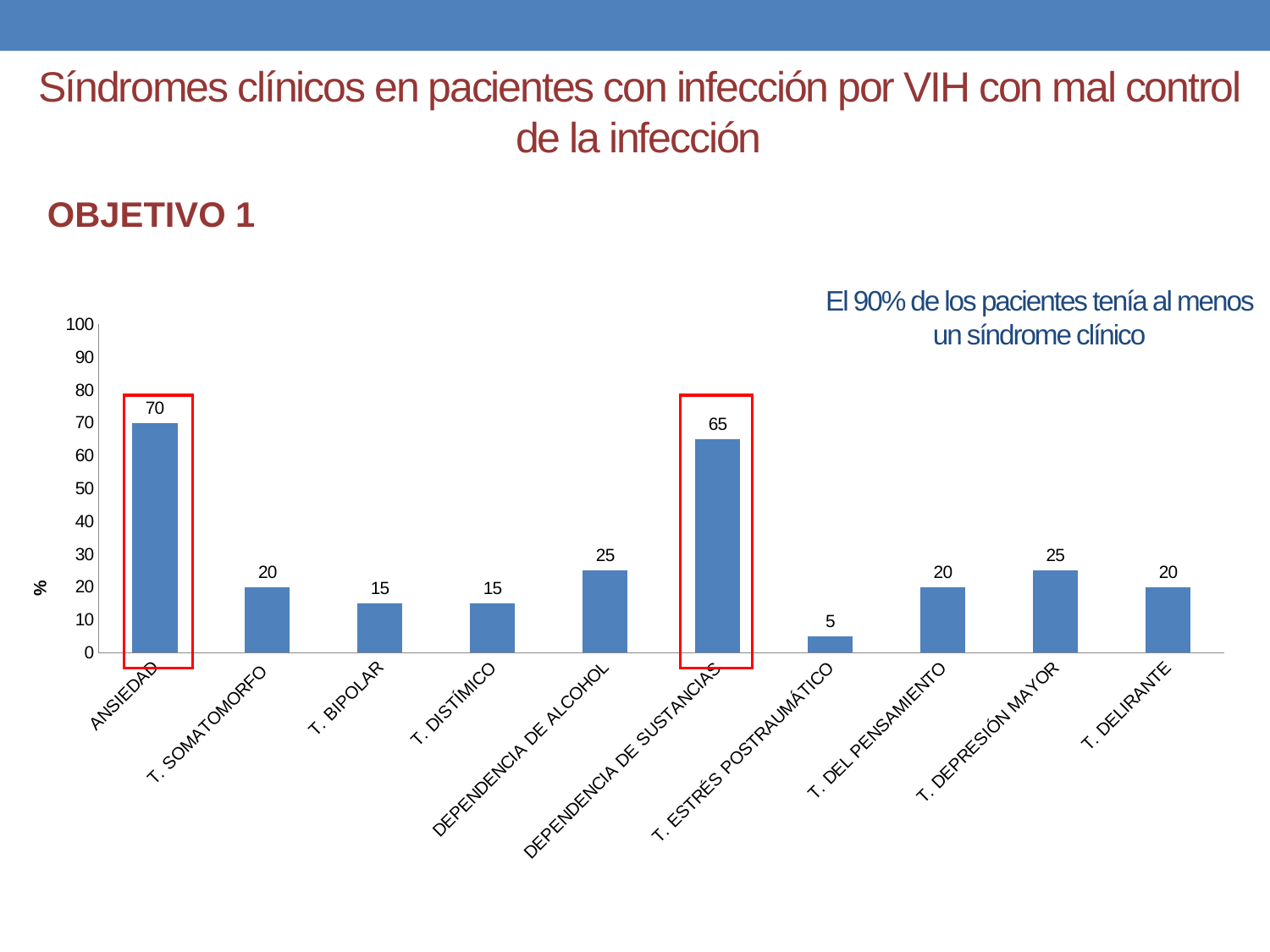
Which is larger, the value for DEPENDENCIA DE ALCOHOL or the value for T. BIPOLAR? DEPENDENCIA DE ALCOHOL How many categories have a value of 20? 3 What is the value for ANSIEDAD? 70 What kind of chart is shown on the slide? bar chart Which category has the highest value? ANSIEDAD What is the label of the y axis? % What is the difference between the values for ANSIEDAD and DEPENDENCIA DE SUSTANCIAS? 5 What is the value for T. ESTRÉS POSTRAUMÁTICO? 5 What is the value for DEPENDENCIA DE SUSTANCIAS? 65 Which category has the lowest value? T. ESTRÉS POSTRAUMÁTICO How many categories are shown on the x axis? 10 What is the value for T. DEPRESIÓN MAYOR? 25